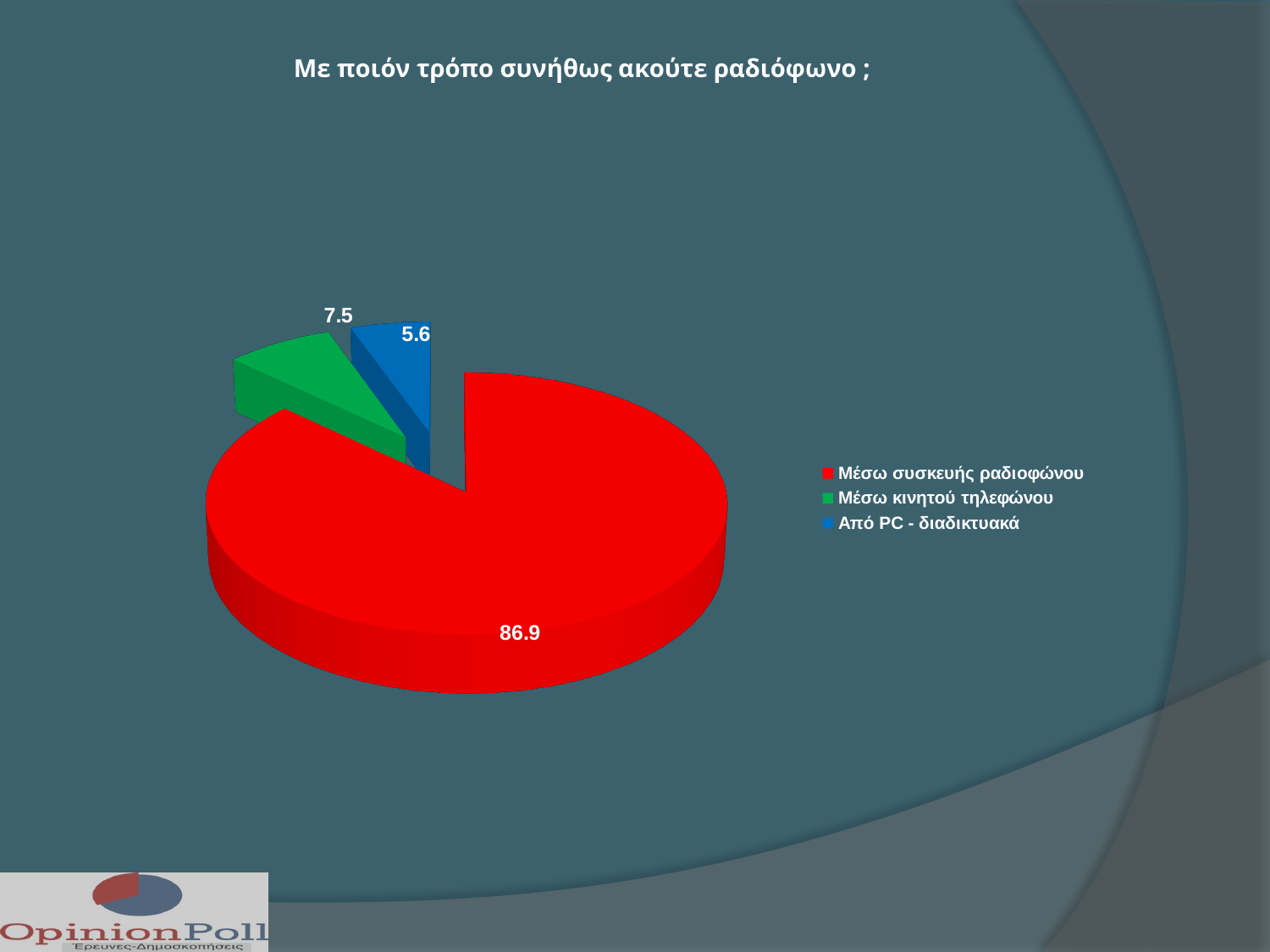
Which category has the largest slice of the pie? Μέσω συσκευής ραδιοφώνου What is the title of the chart? Με ποιόν τρόπο συνήθως ακούτε ραδιόφωνο ; What is the difference between the values for Μέσω συσκευής ραδιοφώνου and Μέσω κινητού τηλεφώνου? 79.4 Which is larger, the value for Μέσω κινητού τηλεφώνου or the value for Από PC - διαδικτυακά? Μέσω κινητού τηλεφώνου How many slices does the pie chart have? 3 What is the value for Από PC - διαδικτυακά? 5.6 What colour is the slice for Μέσω κινητού τηλεφώνου? Green What is the value for Μέσω κινητού τηλεφώνου? 7.5 What is the value for Μέσω συσκευής ραδιοφώνου? 86.9 What type of chart is shown on the slide? Pie chart What is the difference between the values for Μέσω κινητού τηλεφώνου and Από PC - διαδικτυακά? 1.9 Which category has the smallest slice of the pie? Από PC - διαδικτυακά